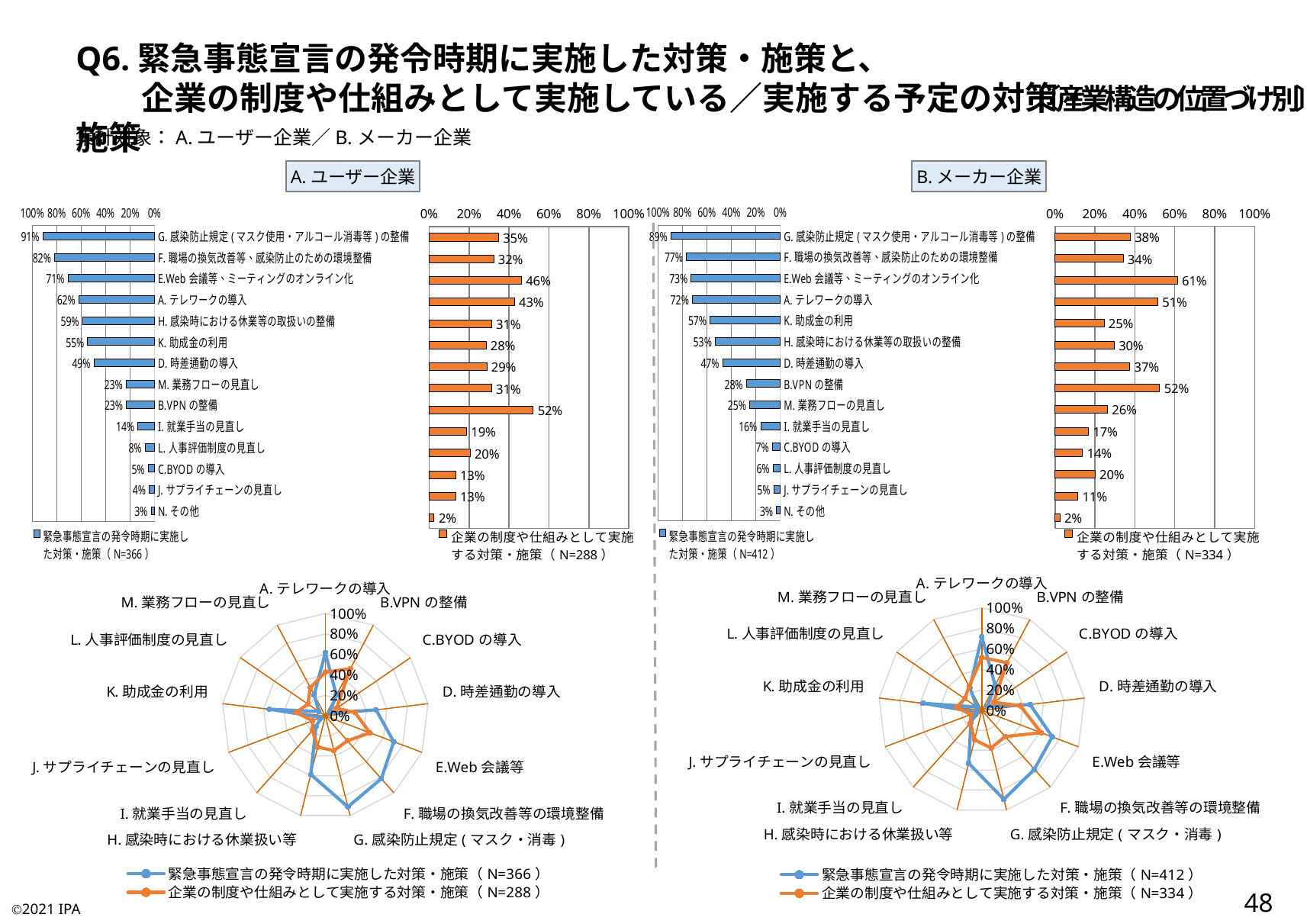
In the B. メーカー企業 bar chart for 緊急事態宣言の発令時期に実施した対策・施策 (N=412), what is the value for A. テレワークの導入? 72% In the A. ユーザー企業 bar chart for 緊急事態宣言の発令時期に実施した対策・施策 (N=366), which category has the lowest value? N. その他 What kind of chart is shown at the bottom of the B. メーカー企業 section? Radar chart In the A. ユーザー企業 bar chart for 企業の制度や仕組みとして実施する対策・施策 (N=288), which is larger: E.Web 会議等 or A. テレワークの導入? E.Web 会議等 In the A. ユーザー企業 bar chart for 企業の制度や仕組みとして実施する対策・施策 (N=288), what is the difference between B.VPN の整備 and N. その他? 50% How many categories are shown in the A. ユーザー企業 bar chart for 緊急事態宣言の発令時期に実施した対策・施策 (N=366)? 14 How many series does the legend of the A. ユーザー企業 radar chart list? 2 In the A. ユーザー企業 bar chart for 企業の制度や仕組みとして実施する対策・施策 (N=288), what is the value for B.VPN の整備? 52% In the A. ユーザー企業 bar chart for 緊急事態宣言の発令時期に実施した対策・施策 (N=366), what is the value for G. 感染防止規定（マスク使用・アルコール消毒等）の整備? 91% In the B. メーカー企業 bar chart for 企業の制度や仕組みとして実施する対策・施策 (N=334), what is the value for D. 時差通勤の導入? 37% In the B. メーカー企業 bar chart for 緊急事態宣言の発令時期に実施した対策・施策 (N=412), what is the difference between G. 感染防止規定 and F. 職場の換気改善等? 12% In the B. メーカー企業 bar chart for 企業の制度や仕組みとして実施する対策・施策 (N=334), which category has the highest value? E.Web 会議等、ミーティングのオンライン化